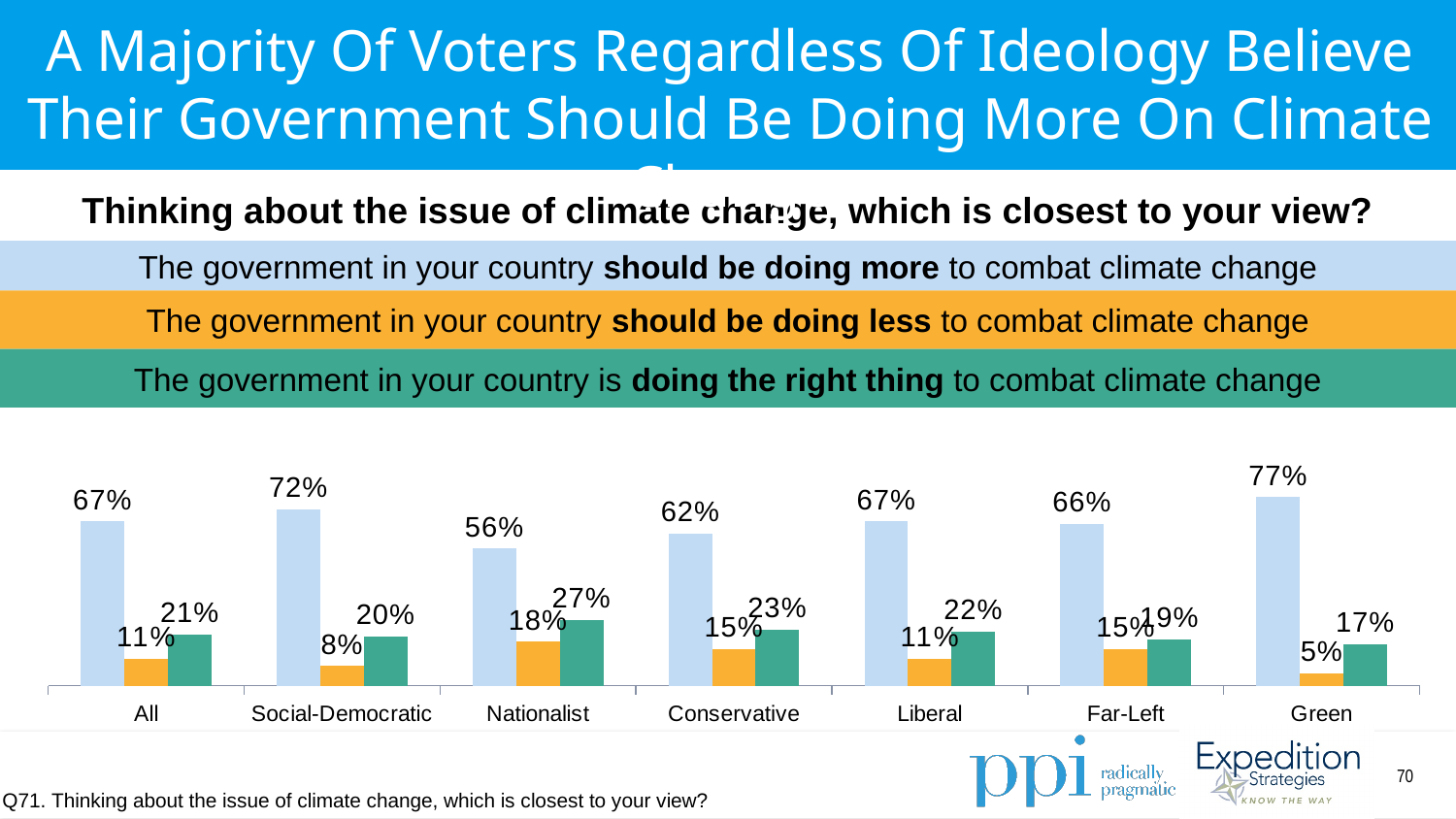
Among Far-Left voters, which is larger: the share saying the government should be doing less or the share saying it is doing the right thing? Doing the right thing How many response options (series) are plotted for each group in the chart? 3 How many ideological groups are shown on the x axis of the chart? 7 What percentage of Conservative voters say the government is doing the right thing to combat climate change? 23% What type of chart is used on this slide? Bar chart What percentage of Nationalist voters say the government should be doing less to combat climate change? 18% What is the difference between the Social-Democratic and Nationalist shares saying the government should be doing more? 16 percentage points Which group has the lowest share saying the government should be doing less to combat climate change? Green Which colour represents the response that the government should be doing less to combat climate change? Orange What percentage of Green voters say the government should be doing more to combat climate change? 77% Which ideological group has the highest share saying the government should be doing more on climate change? Green Which ideological group has the lowest share saying the government should be doing more on climate change? Nationalist